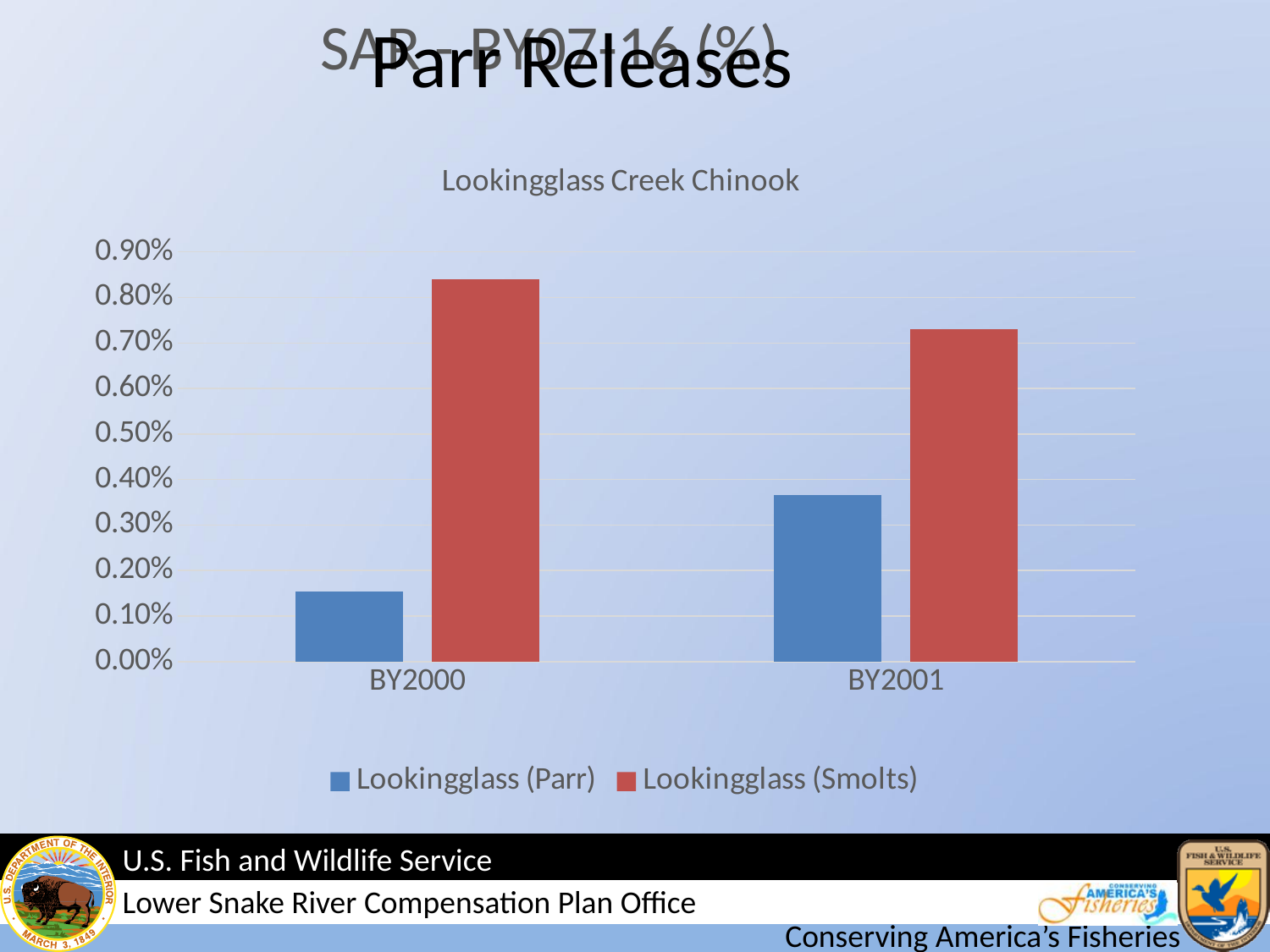
How many brood-year categories are shown on the x axis? 2 Is the Lookingglass (Smolts) value for BY2000 greater or less than 0.80%? greater Does the Lookingglass (Smolts) value rise or fall from BY2000 to BY2001? fall What kind of chart is shown on the slide? bar chart What is the title of the chart? Lookingglass Creek Chinook Is the Lookingglass (Parr) value for BY2000 greater or less than 0.20%? less Which bar is the shortest in the chart? Lookingglass (Parr) for BY2000 Which bar is the tallest in the chart? Lookingglass (Smolts) for BY2000 How many series does the chart legend list? 2 Is the Lookingglass (Smolts) value for BY2001 greater or less than 0.80%? less Which series is shown in red? Lookingglass (Smolts)